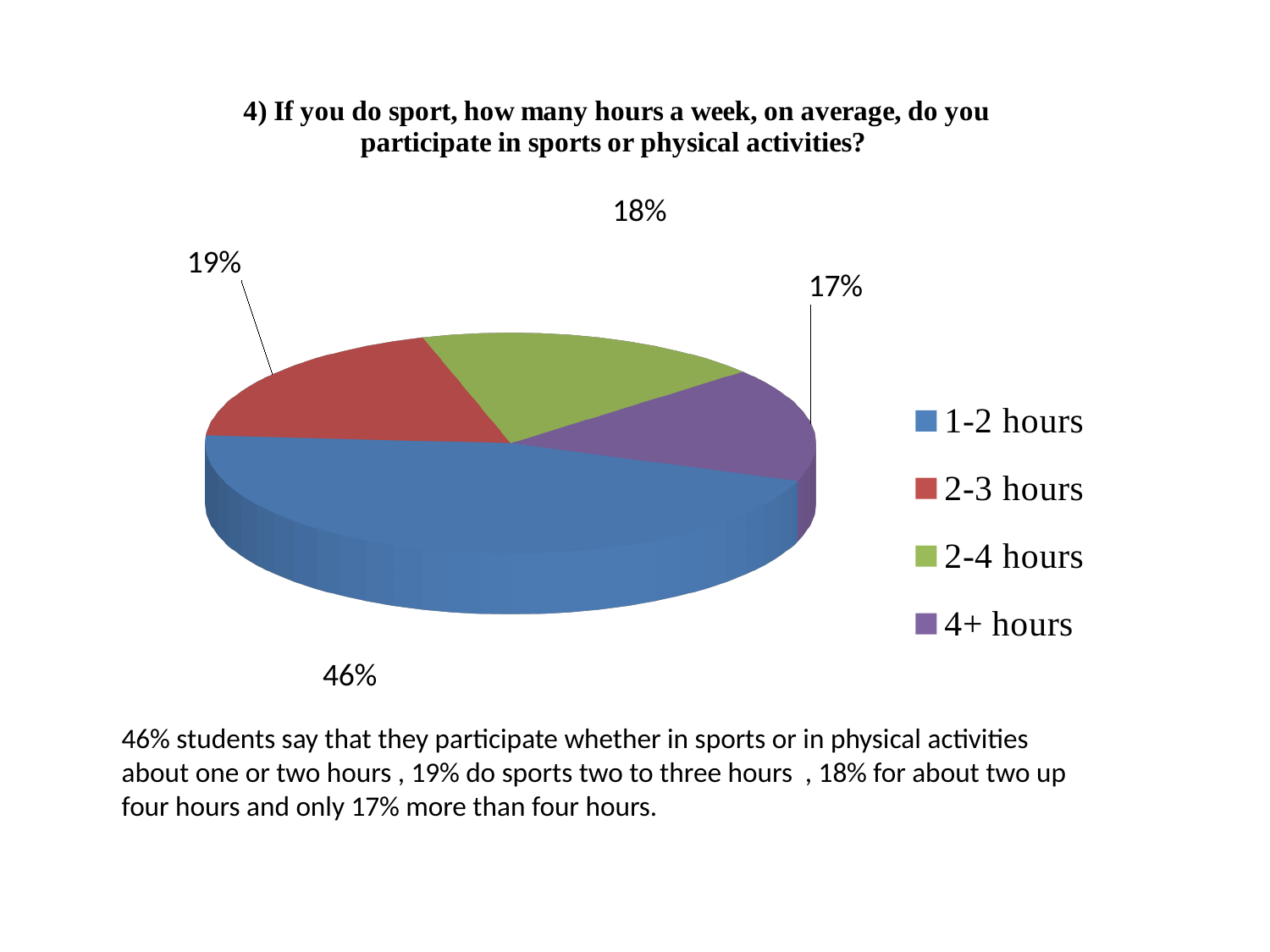
What colour is the slice representing 4+ hours? Purple What is the difference in percentage points between the 1-2 hours slice and the 2-3 hours slice? 27% What percentage of students participate in sports for 4+ hours a week? 17% Which category has the smallest share of the pie? 4+ hours Which is larger, the share for 2-3 hours or the share for 2-4 hours? 2-3 hours What kind of chart is shown on the slide? Pie chart What percentage of students participate in sports for 2-3 hours a week? 19% Which category has the largest share of the pie? 1-2 hours How many entries does the legend list? 4 What percentage of students participate in sports for 2-4 hours a week? 18% What percentage of students participate in sports for 1-2 hours a week? 46% How many categories are shown in the pie chart? 4